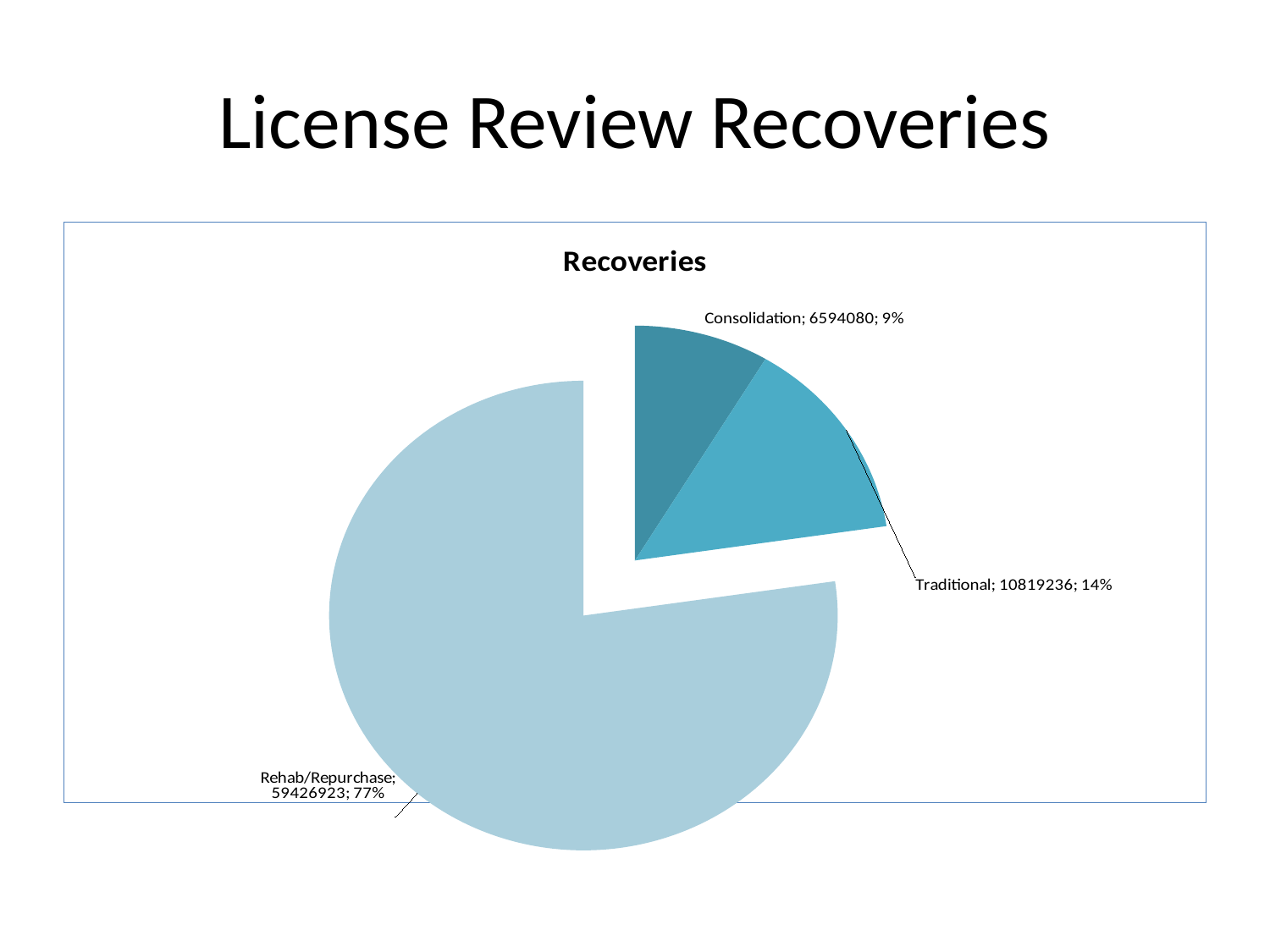
What is the difference between the values for Traditional and Consolidation? 4225156 What type of chart is shown on the slide? pie chart What share of the pie does Rehab/Repurchase represent? 77% How many slices does the pie chart have? 3 What is the value for Rehab/Repurchase? 59426923 Which category has the largest value? Rehab/Repurchase What share of the pie does Traditional represent? 14% Which category has the smallest value? Consolidation What is the value for Consolidation? 6594080 What share of the pie does Consolidation represent? 9% What is the value for Traditional? 10819236 What is the title of the chart? Recoveries